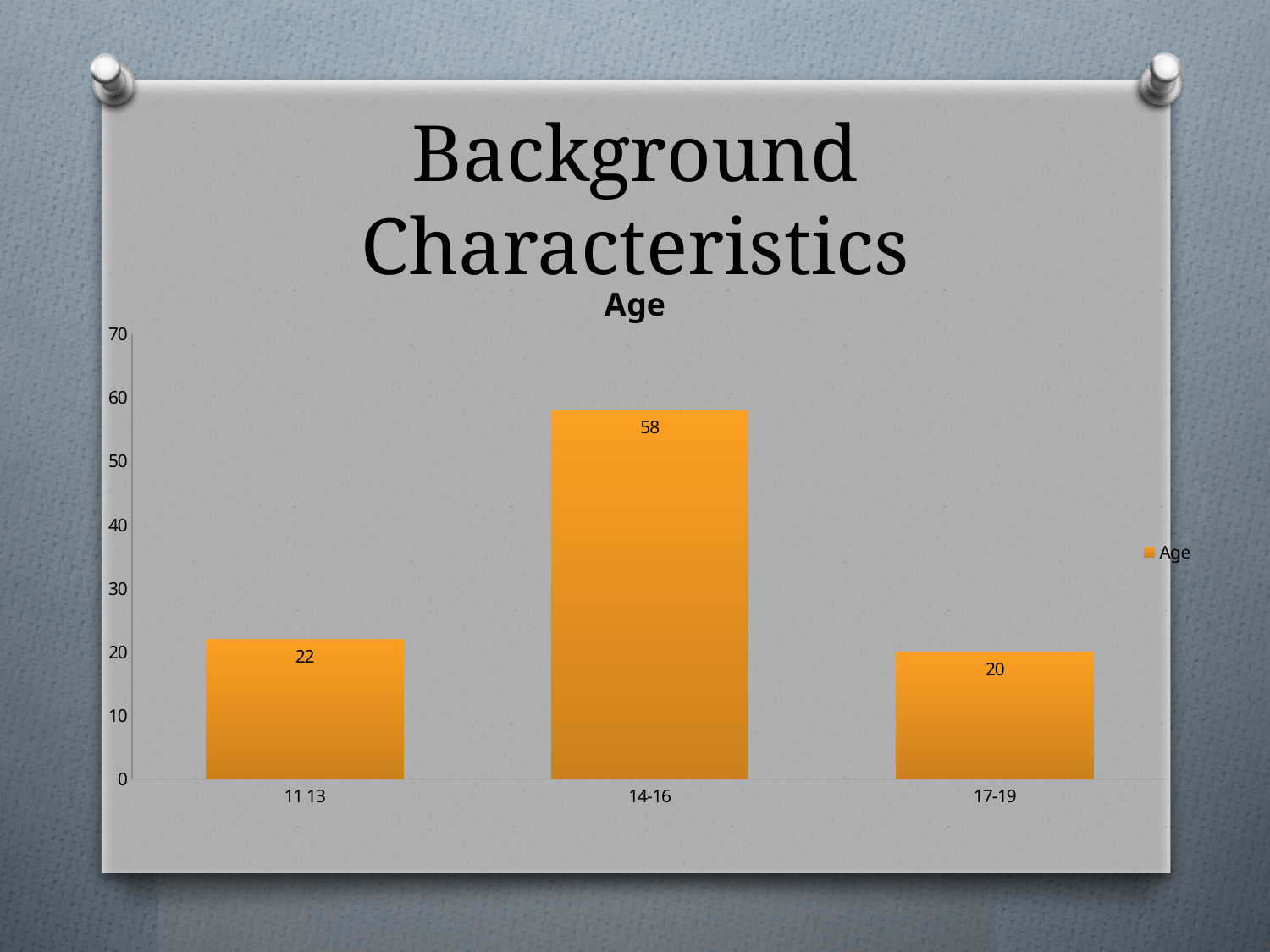
What is the value for the 14-16 age group? 58 What kind of chart is shown on the slide? bar chart Which age group has the highest value? 14-16 Is the value for 14-16 greater or less than 50? greater How many age groups are shown on the chart? 3 What is the title of the chart? Age Which is larger, the value for 14-16 or the value for 17-19? 14-16 What is the value for the 11 13 age group? 22 What is the difference between the values for 11 13 and 17-19? 2 What is the value for the 17-19 age group? 20 What is the difference between the values for 14-16 and 11 13? 36 Which age group has the lowest value? 17-19